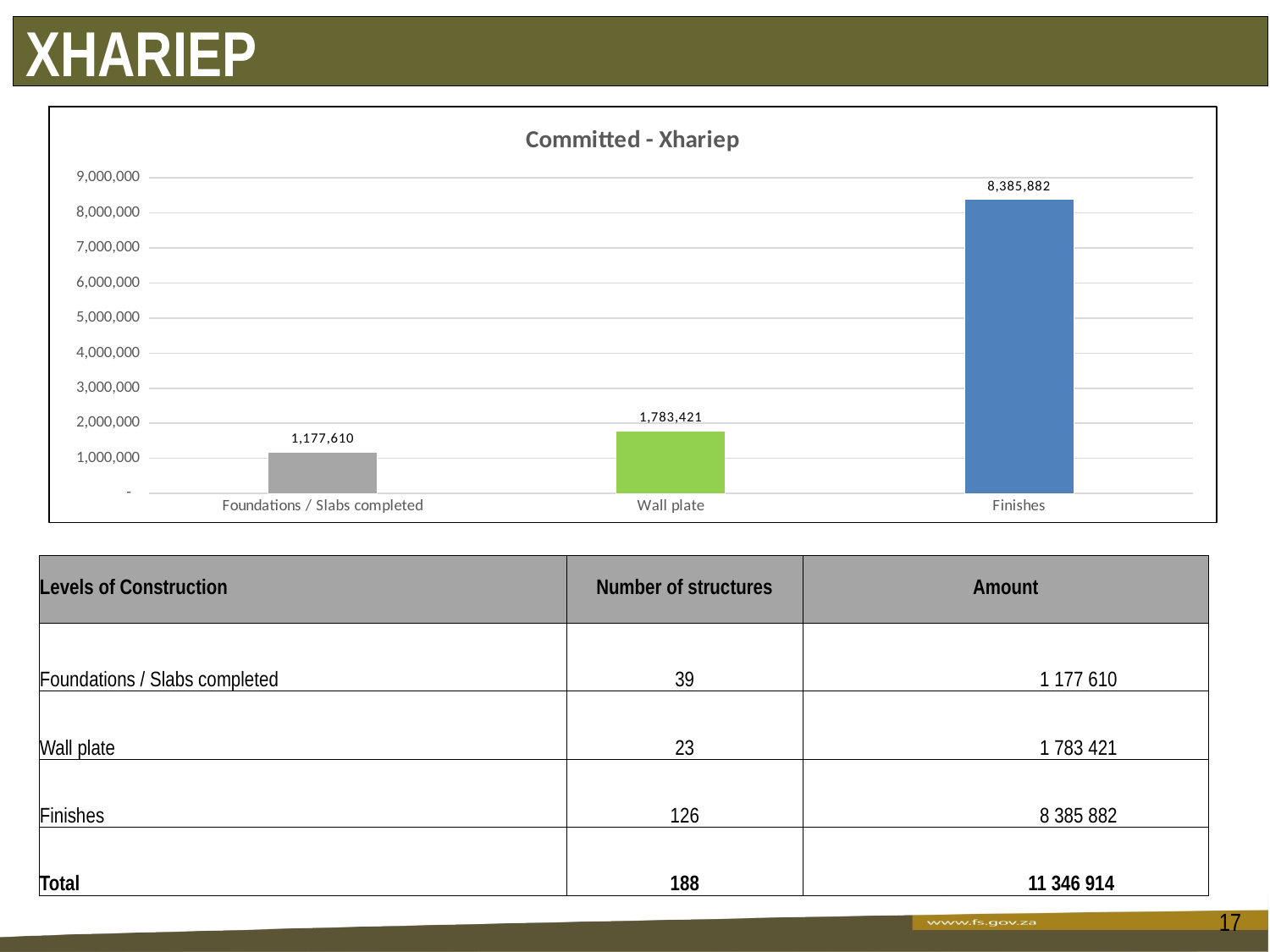
What is the difference between the values for Finishes and Wall plate in the Committed - Xhariep chart? 6,602,461 What is the value for Foundations / Slabs completed in the Committed - Xhariep chart? 1,177,610 What is the value for Finishes in the Committed - Xhariep chart? 8,385,882 How many categories are shown in the Committed - Xhariep chart? 3 Which category has the lowest value in the Committed - Xhariep chart? Foundations / Slabs completed What is the value for Wall plate in the Committed - Xhariep chart? 1,783,421 Which category has the highest value in the Committed - Xhariep chart? Finishes Which is larger in the Committed - Xhariep chart, Wall plate or Foundations / Slabs completed? Wall plate What is the difference between the values for Wall plate and Foundations / Slabs completed in the Committed - Xhariep chart? 605,811 Is the value for Finishes in the Committed - Xhariep chart greater or less than 8,000,000? greater What is the title of the chart on the slide? Committed - Xhariep What kind of chart is the Committed - Xhariep chart? bar chart